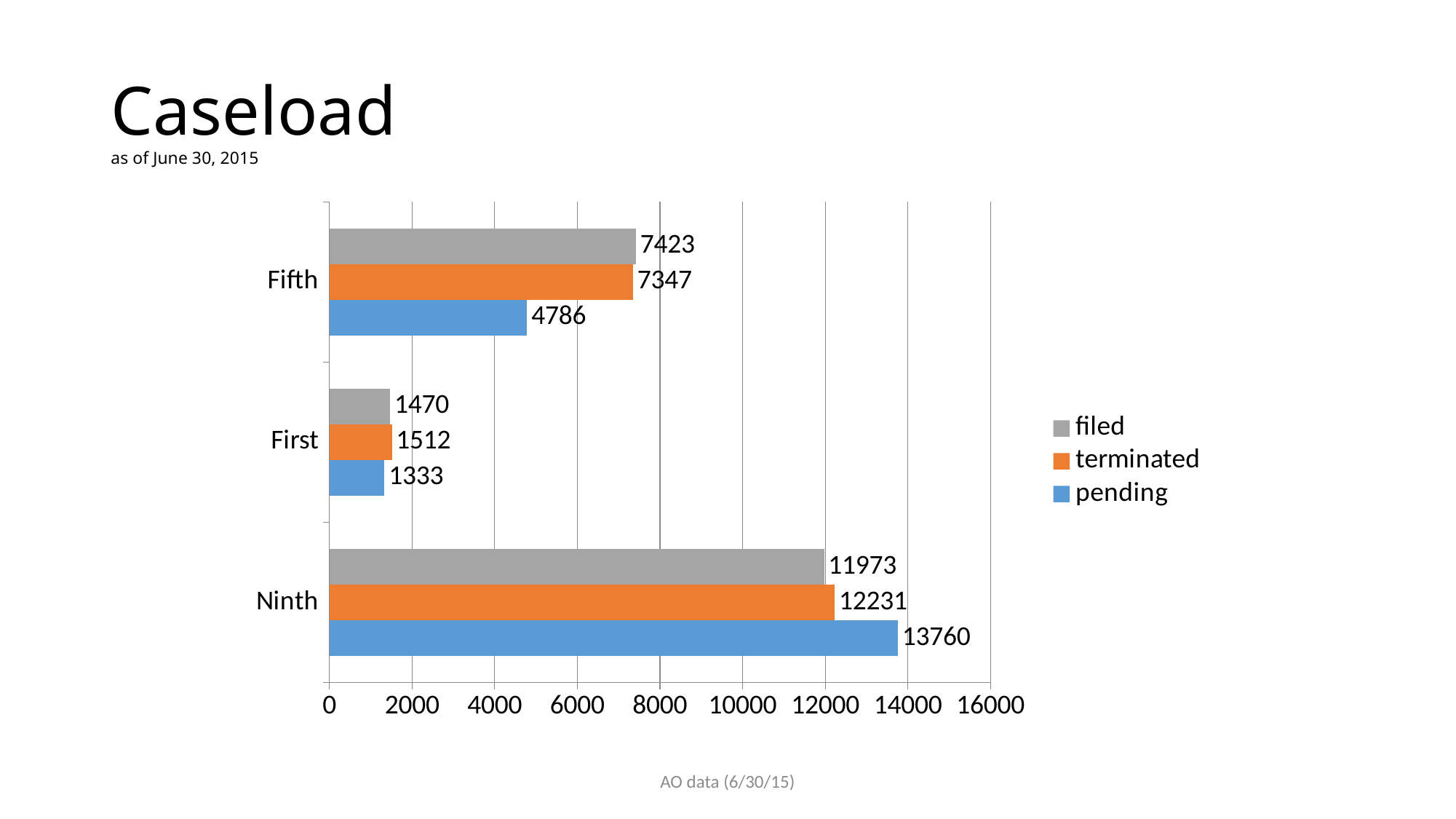
How many series does the legend list? 3 Which is larger for the Ninth circuit, filed or terminated cases? terminated What is the number of pending cases for the Ninth circuit? 13760 What is the difference between pending and filed cases for the Ninth circuit? 1787 What kind of chart is shown on the slide? bar chart Which circuit has the lowest number of filed cases? First Is the value for pending cases in the Fifth circuit greater or less than 6000? less How many circuits are shown on the chart? 3 What is the number of filed cases for the Fifth circuit? 7423 Which circuit has the highest number of pending cases? Ninth What is the difference between terminated and pending cases for the Fifth circuit? 2561 What is the number of terminated cases for the First circuit? 1512